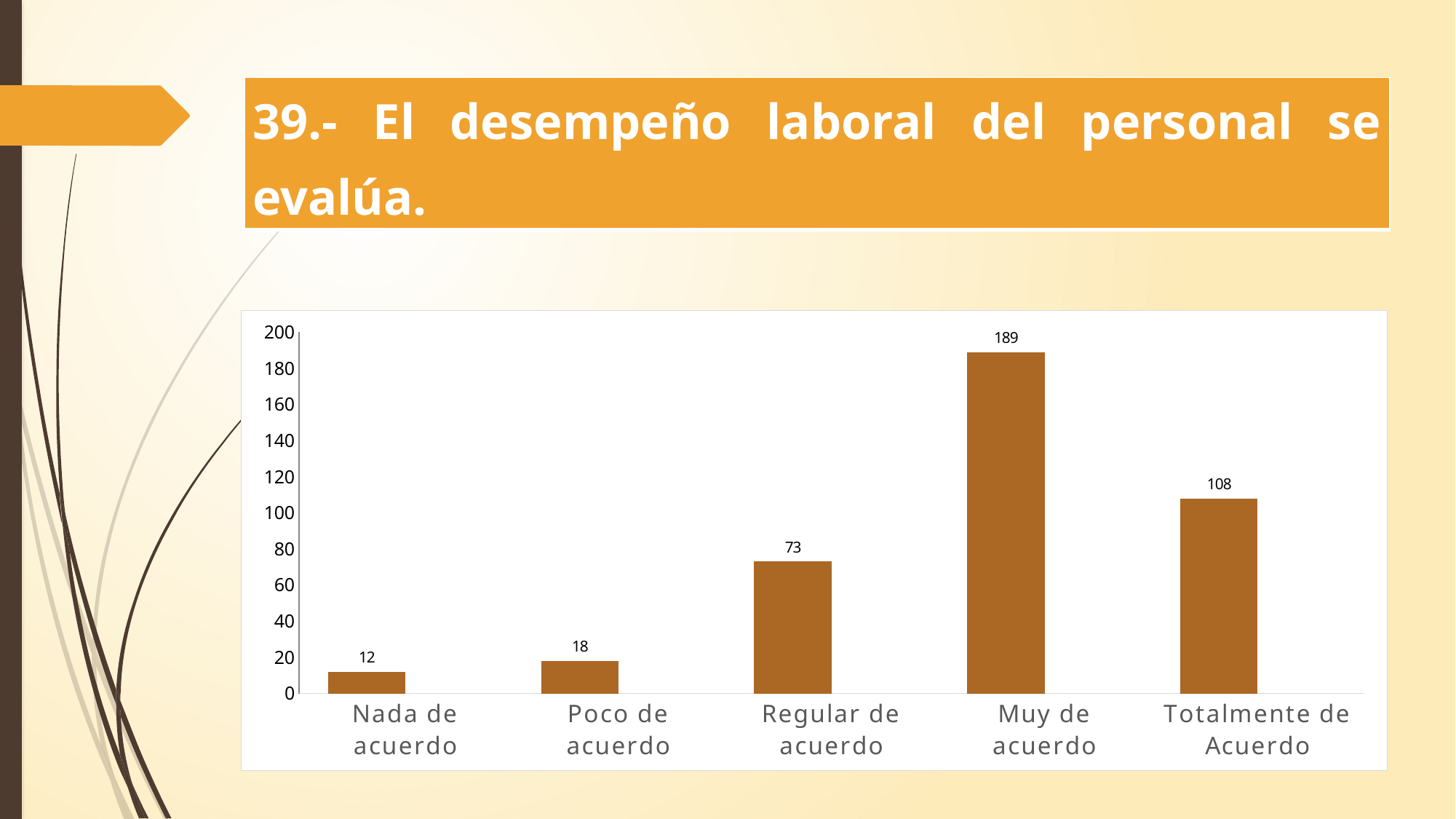
Which category has the lowest value? Nada de acuerdo Is the value for "Totalmente de Acuerdo" greater or less than 100? greater What is the difference between the values for "Muy de acuerdo" and "Totalmente de Acuerdo"? 81 What is the value for "Totalmente de Acuerdo"? 108 How many categories are shown on the x axis? 5 What is the value for "Nada de acuerdo"? 12 Which is larger, the value for "Poco de acuerdo" or the value for "Regular de acuerdo"? Regular de acuerdo What is the value for "Muy de acuerdo"? 189 What kind of chart is shown on the slide? bar chart What is the value for "Regular de acuerdo"? 73 What is the title of the slide above the chart? 39.- El desempeño laboral del personal se evalúa. Which category has the highest value? Muy de acuerdo